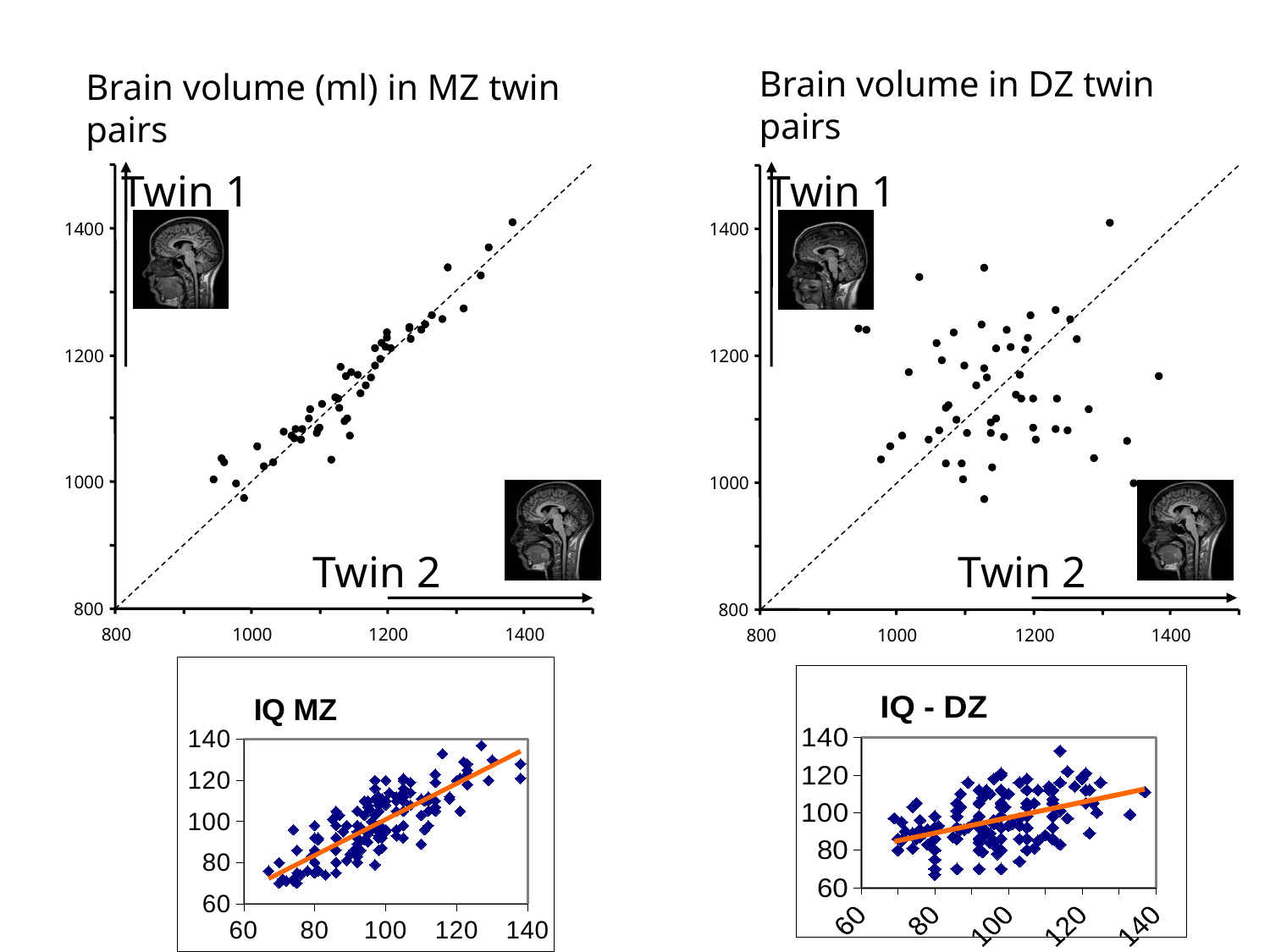
What kind of chart is the 'IQ MZ' chart? scatter chart In the 'IQ - DZ' chart, do the values rise or fall along the x axis? rise In the 'Brain volume (ml) in MZ twin pairs' chart, what is the label of the horizontal axis? Twin 2 How many charts are shown on the slide? 4 In the 'IQ MZ' chart, do the values rise or fall along the x axis? rise In the 'Brain volume in DZ twin pairs' chart, what is the label of the vertical axis? Twin 1 What kind of chart is the 'Brain volume (ml) in MZ twin pairs' chart? scatter chart